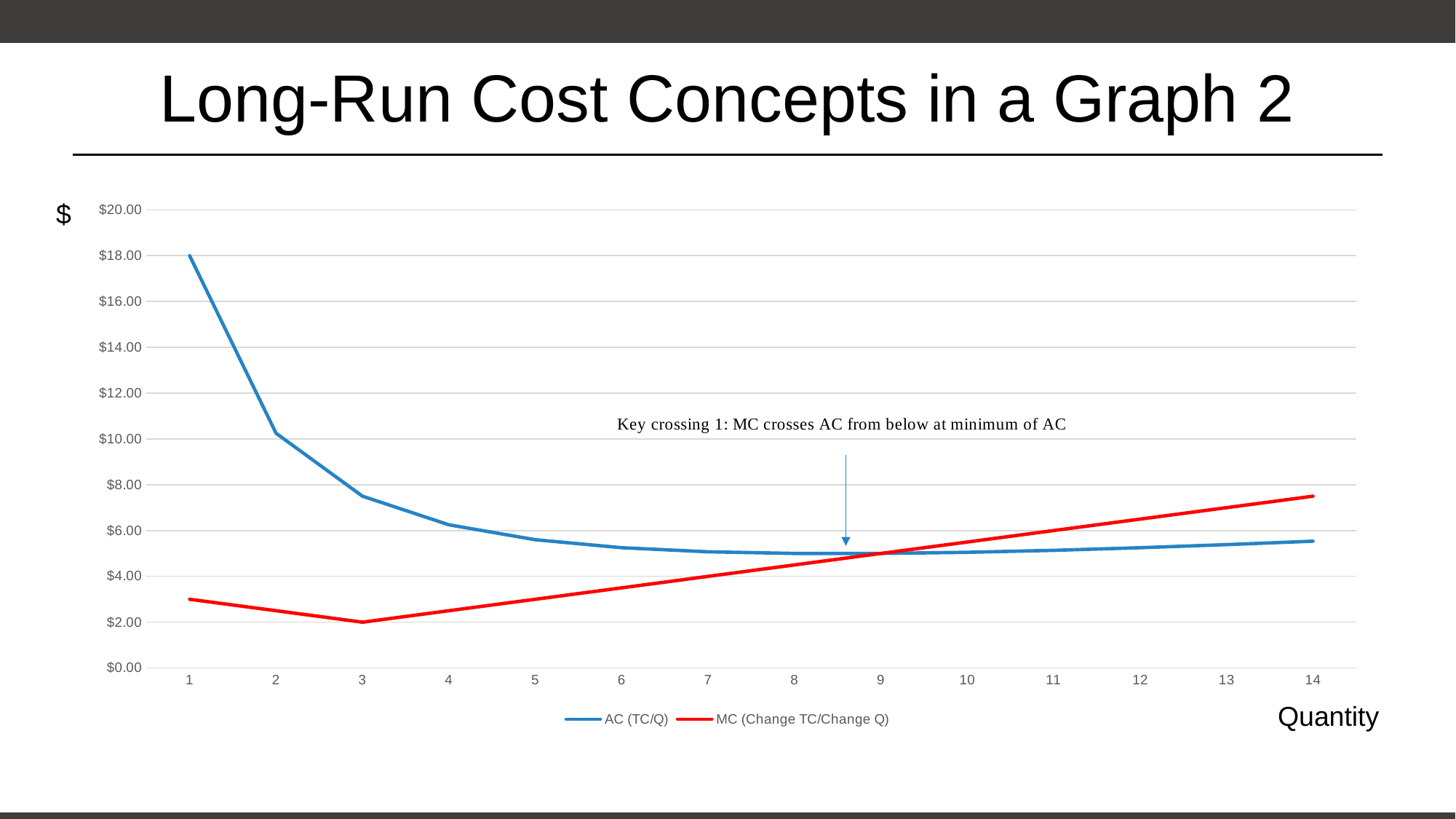
What is the value of AC (TC/Q) at quantity 1? $18.00 What kind of chart is shown on the slide? line chart What does the annotation on the chart say about the key crossing? Key crossing 1: MC crosses AC from below at minimum of AC Is the value of AC (TC/Q) at quantity 3 greater or less than $8.00? less How many series does the legend list? 2 How many quantity values are plotted along the x axis? 14 At which quantity is AC (TC/Q) highest? 1 Does MC (Change TC/Change Q) rise or fall from quantity 3 to quantity 14? rise Is the value of MC (Change TC/Change Q) at quantity 1 greater or less than $2.00? greater At which quantity is MC (Change TC/Change Q) lowest? 3 What is the value of MC (Change TC/Change Q) at quantity 3? $2.00 At quantity 14, which series has the larger value, AC (TC/Q) or MC (Change TC/Change Q)? MC (Change TC/Change Q)